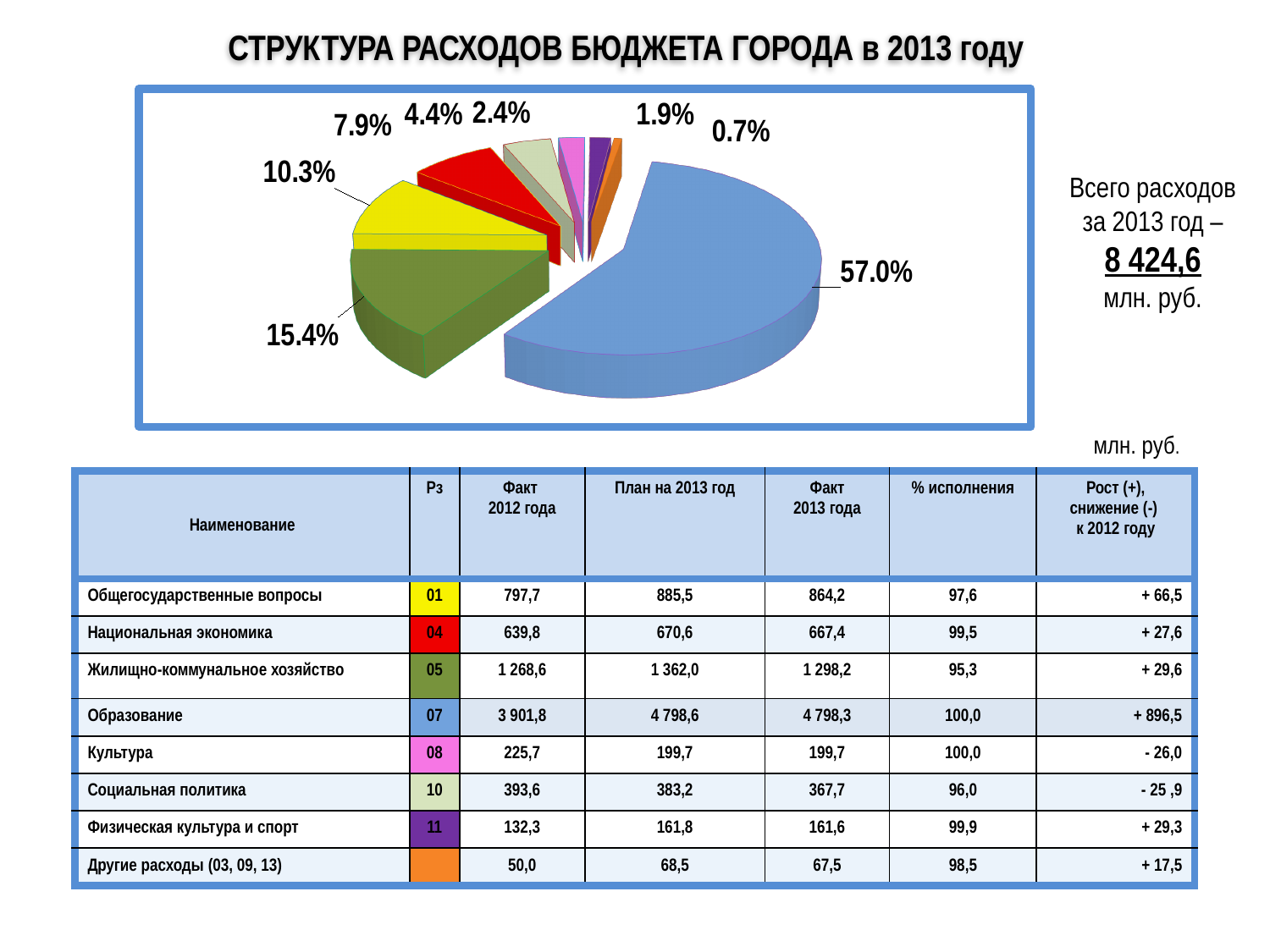
Which slice of the pie chart is the smallest? Другие расходы (0.7%) What total expenditure for 2013 is stated next to the pie chart? 8 424,6 млн. руб. What kind of chart is shown on the slide? pie chart Which is larger in the pie chart: the 4.4% slice (Социальная политика) or the 2.4% slice (Культура)? Социальная политика (4.4%) What is the difference in percentage points between the 57.0% slice and the 15.4% slice? 41.6 How many slices does the pie chart have? 8 Which slice of the pie chart is the largest? Образование (57.0%) What share of the pie does the green slice, Жилищно-коммунальное хозяйство, represent? 15.4% What share of the pie does the red slice, Национальная экономика, represent? 7.9% What share of the pie does the yellow slice, Общегосударственные вопросы, represent? 10.3% What is the title of the slide containing the pie chart? СТРУКТУРА РАСХОДОВ БЮДЖЕТА ГОРОДА в 2013 году